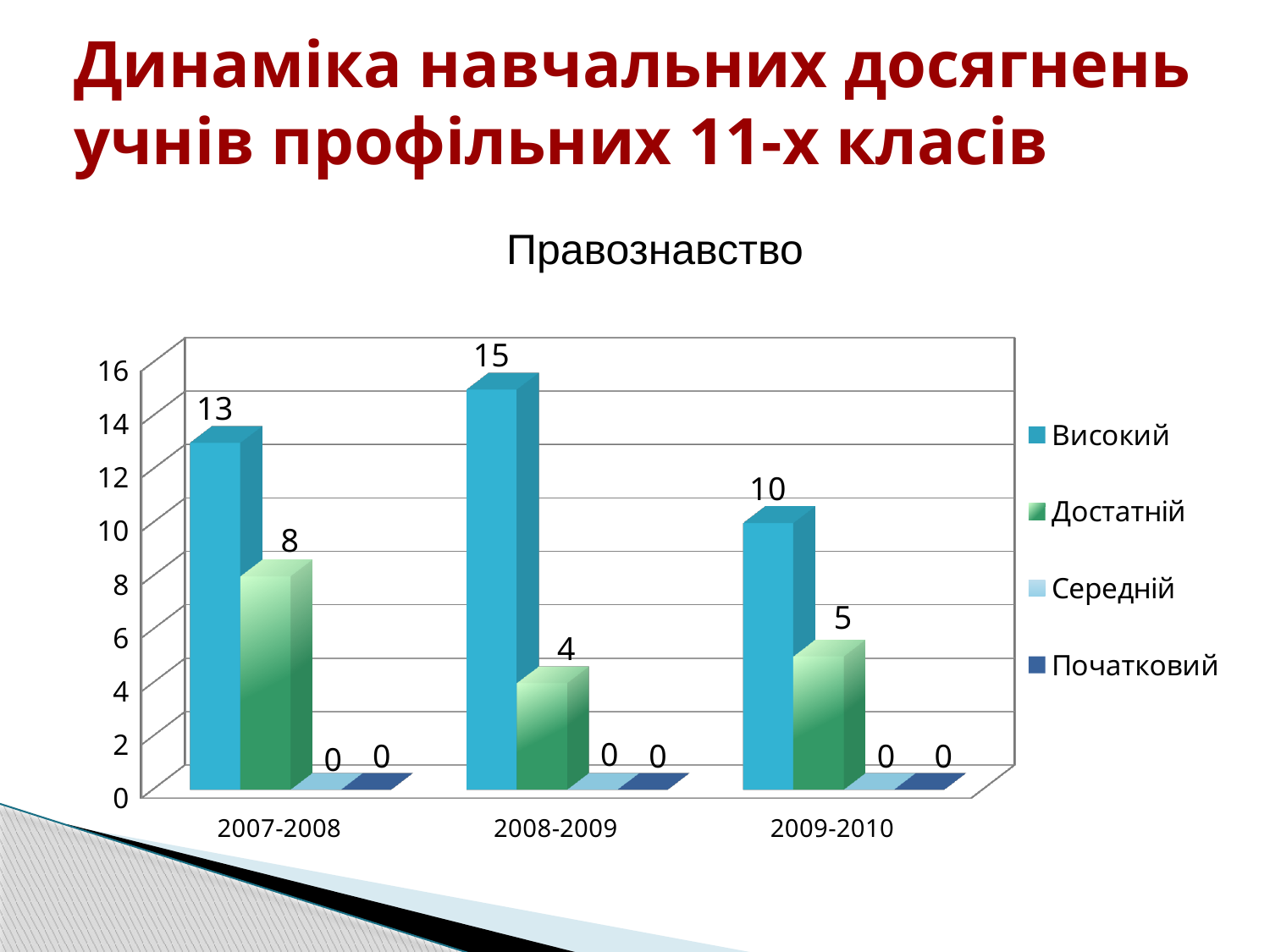
What is the value for Достатній in 2007-2008? 8 What is the value for Високий in 2008-2009? 15 In which year is the Високий value highest? 2008-2009 What is the difference between the Високий and Достатній values in 2009-2010? 5 In which year is the Достатній value lowest? 2008-2009 What is the title of the chart? Правознавство Does the Високий value rise or fall from 2008-2009 to 2009-2010? fall What kind of chart is shown? bar chart How many series does the legend list? 4 How many year categories are shown on the x axis? 3 What is the value for Середній in 2009-2010? 0 Which is larger in 2007-2008: Високий or Достатній? Високий